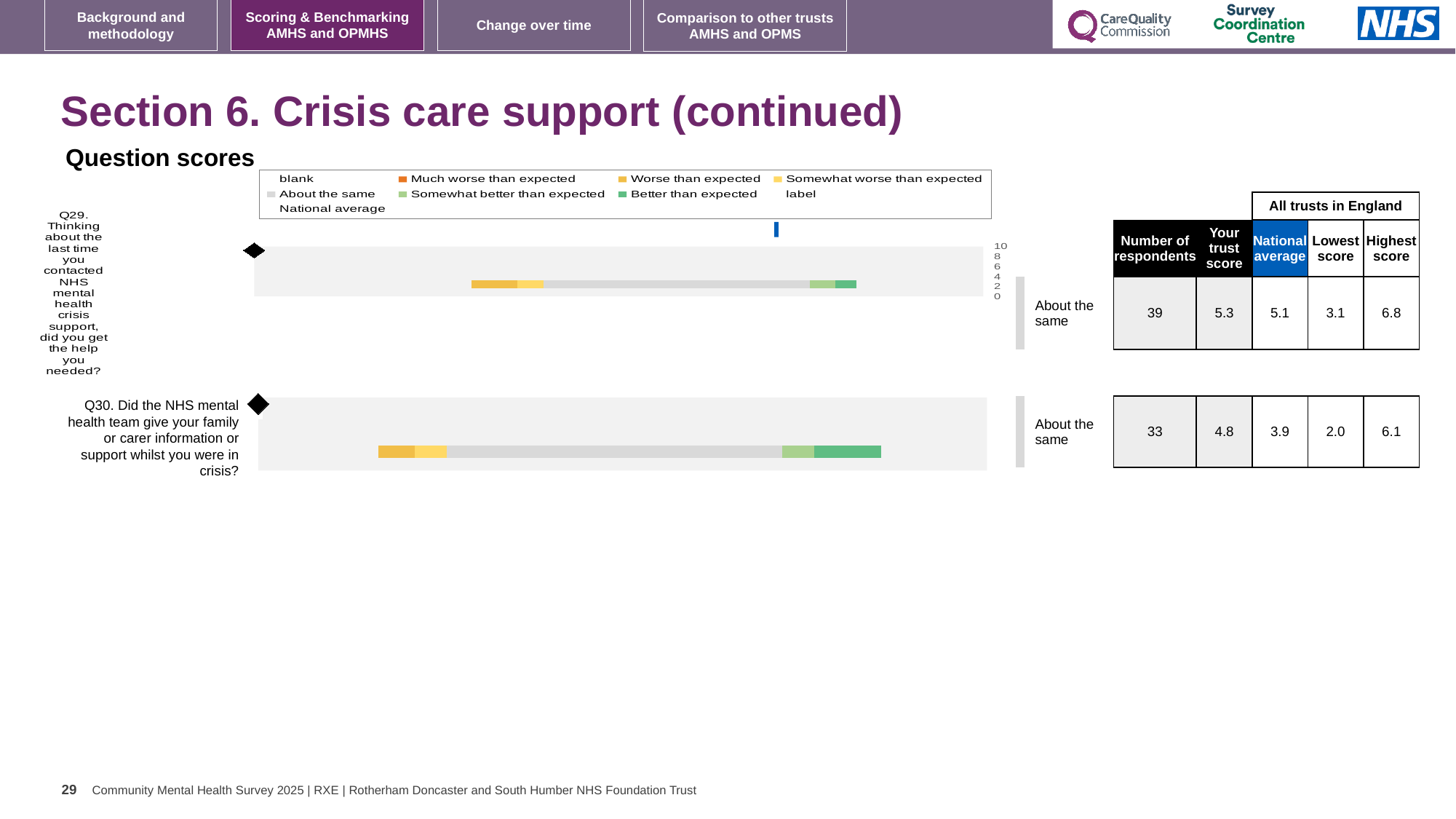
What is the trust score shown for Q30 (did the NHS mental health team give your family or carer information or support)? 4.8 For Q30, which is larger: the trust score or the national average? the trust score What benchmark category is shown next to the bar for Q29? About the same What is the trust score shown for Q29 (did you get the help you needed from NHS mental health crisis support)? 5.3 How many questions are plotted in the question scores chart? 2 How many respondents are shown for Q29? 39 What is the national average shown for Q29? 5.1 What is the national average shown for Q30? 3.9 What is the difference between the trust score and the national average for Q30? 0.9 What kind of chart is used to show the question scores for Q29 and Q30? bar chart How many respondents are shown for Q30? 33 What is the highest score across all trusts in England shown for Q30? 6.1